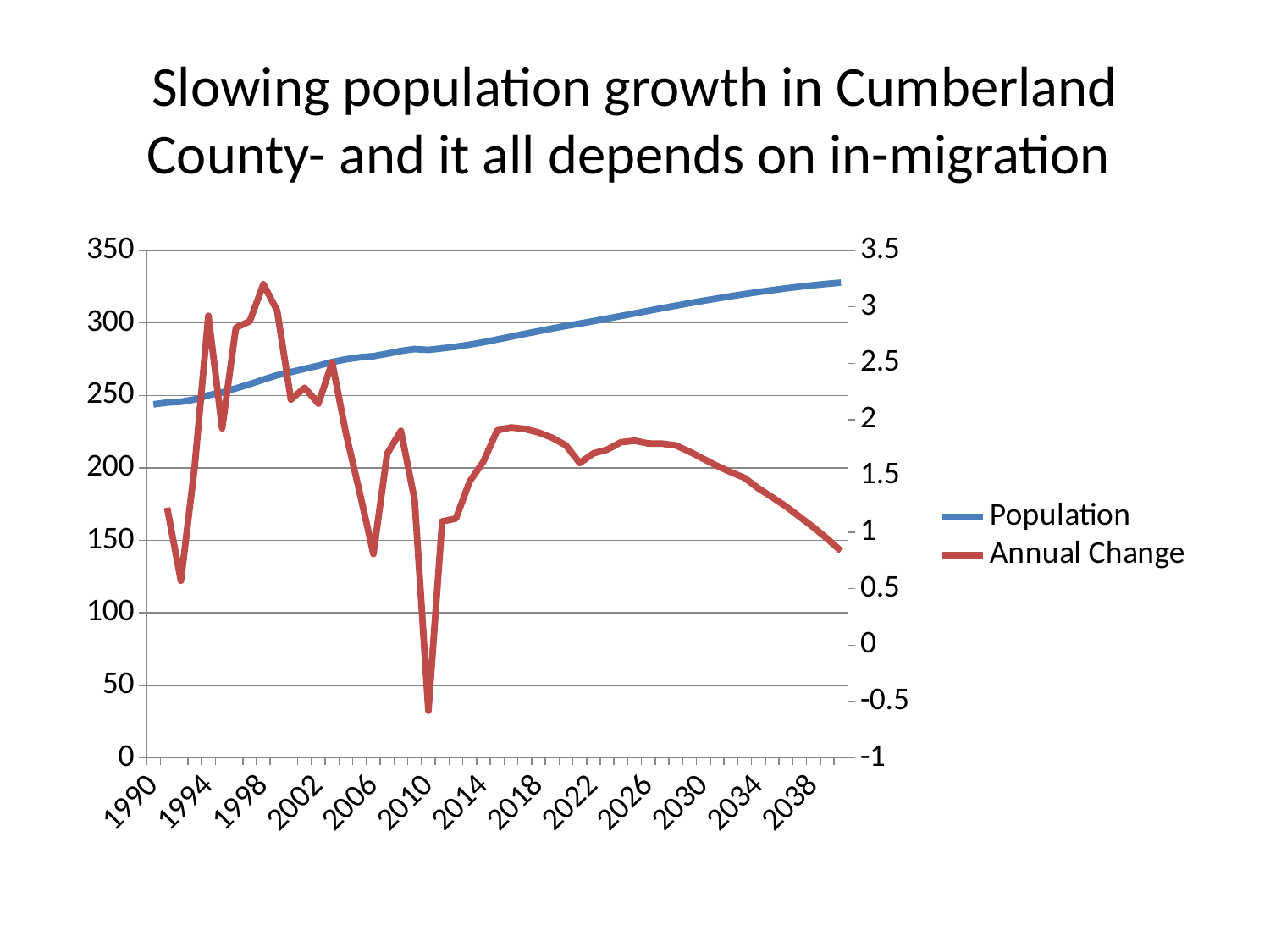
Does the Population series rise or fall from 1990 to 2038? Rise Which is larger, the Population value for 2038 or for 1990? 2038 What is the title of the slide? Slowing population growth in Cumberland County- and it all depends on in-migration Is the Population value for 1990 greater or less than 200? greater Is the Population value for 2038 greater or less than 300? greater Is the Annual Change value for 2030 greater or less than 1? greater Which is larger, the Annual Change value for 1998 or for 2010? 1998 Does the Annual Change series rise or fall from 2018 to 2038? Fall Which colour is used for the Population series? Blue What kind of chart is shown on the slide? Line chart How many series does the legend list? 2